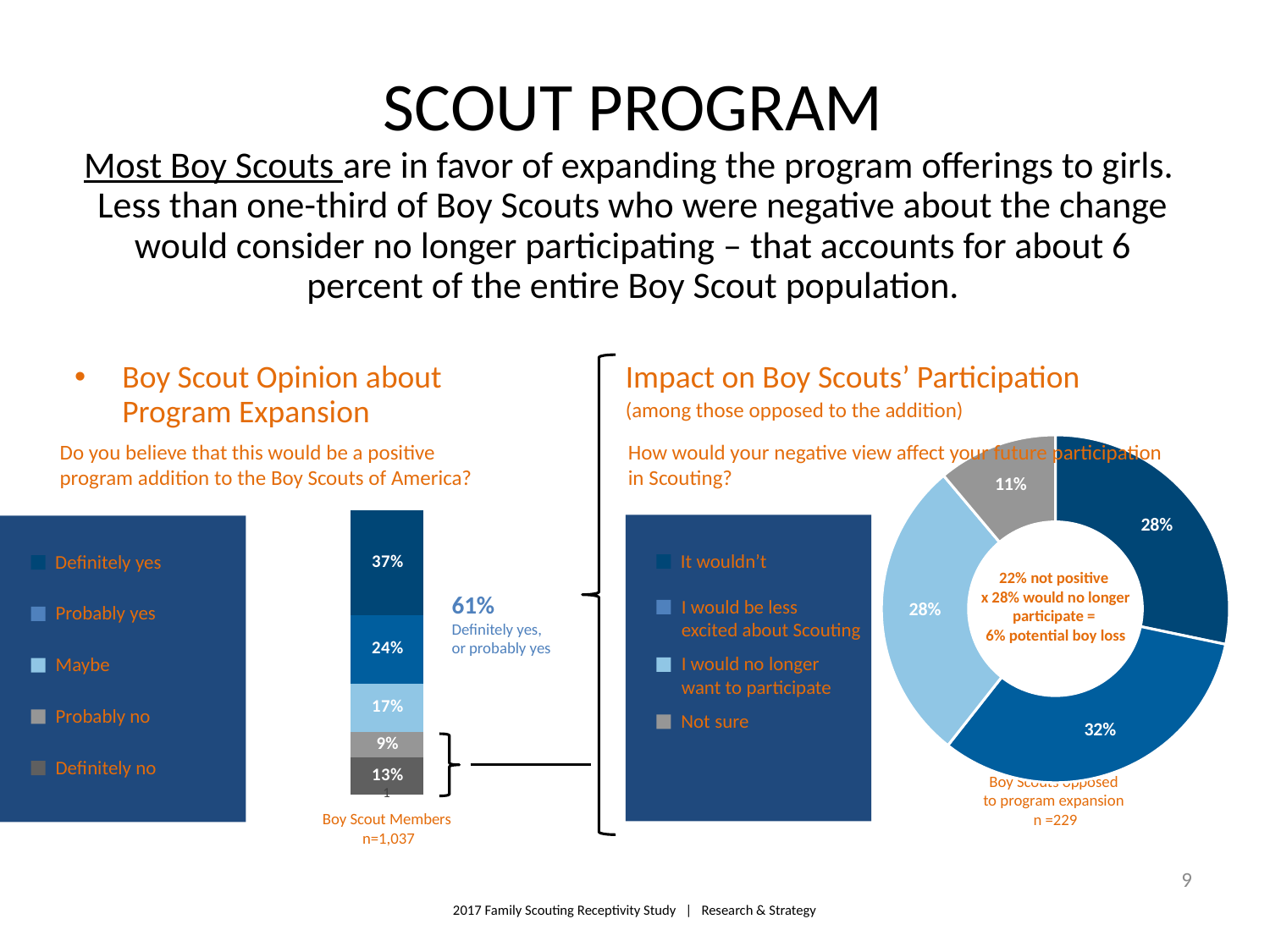
In the Boy Scout Opinion about Program Expansion chart, what percentage of Boy Scout members answered 'Definitely yes'? 37% What type of chart is used for Impact on Boy Scouts' Participation? Donut chart In the Impact on Boy Scouts' Participation chart, what percentage said 'I would be less excited about Scouting'? 32% In the Boy Scout Opinion about Program Expansion chart, which response category has the highest percentage? Definitely yes In the Impact on Boy Scouts' Participation chart, what percentage said 'Not sure'? 11% In the Boy Scout Opinion about Program Expansion chart, what is the combined percentage for 'Definitely yes' and 'Probably yes' as labelled on the slide? 61% In the Boy Scout Opinion about Program Expansion chart, which response category has the lowest percentage? Probably no What type of chart is used for Boy Scout Opinion about Program Expansion? Stacked bar chart How many response categories does the legend of the Boy Scout Opinion about Program Expansion chart list? 5 In the Boy Scout Opinion about Program Expansion chart, what percentage answered 'Definitely no'? 13% In the Impact on Boy Scouts' Participation chart, which response has the largest share? I would be less excited about Scouting In the Boy Scout Opinion about Program Expansion chart, what is the difference between the 'Definitely yes' and 'Probably yes' percentages? 13%